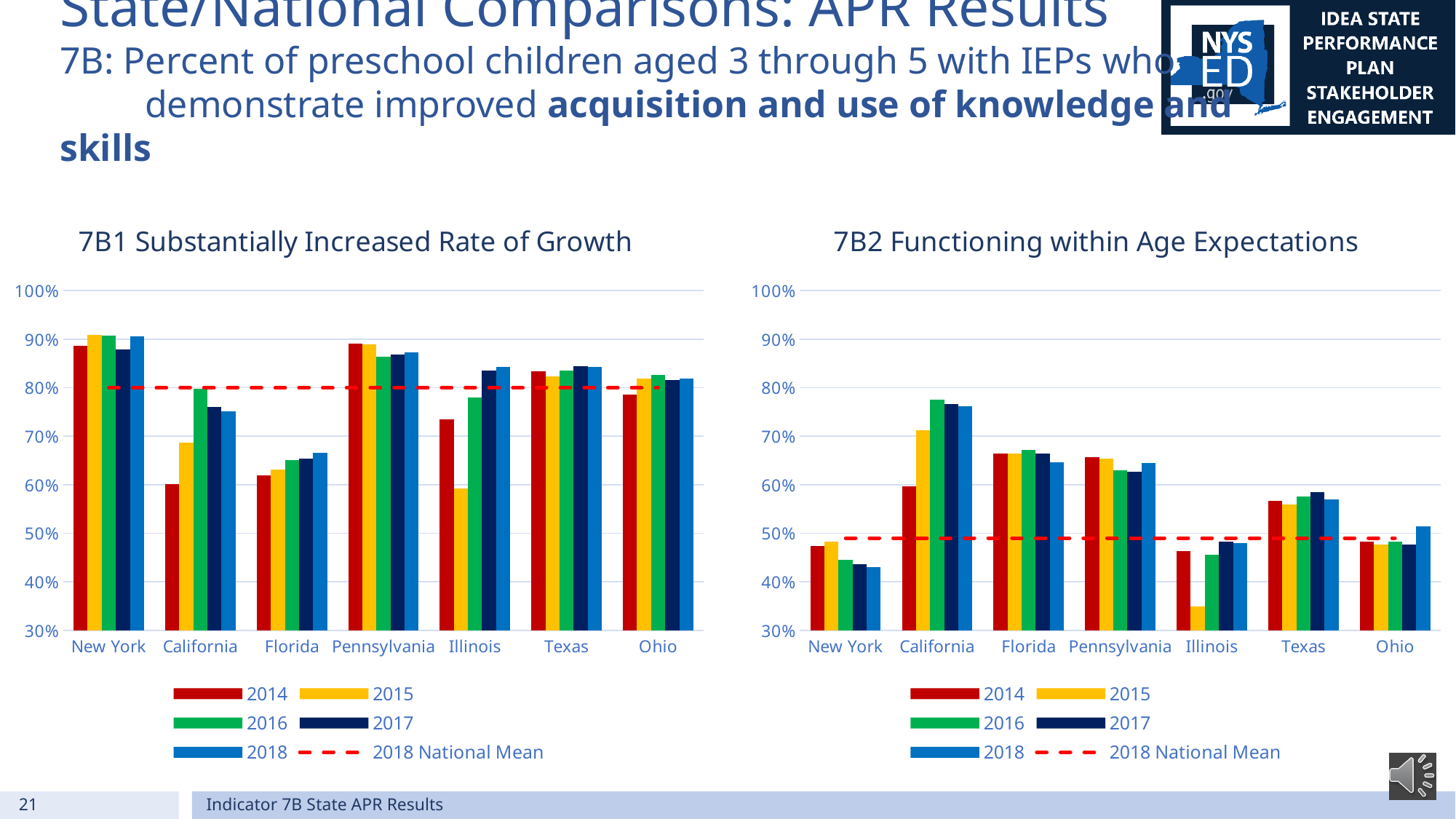
In the 7B1 Substantially Increased Rate of Growth chart, do Florida's values rise or fall from 2014 to 2018? rise In the 7B2 Functioning within Age Expectations chart, is the 2016 value for California greater or less than 70%? greater In the 7B1 Substantially Increased Rate of Growth chart, what kind of chart is used? bar chart In the 7B1 Substantially Increased Rate of Growth chart, is the 2014 value for California greater or less than 70%? less In the 7B2 Functioning within Age Expectations chart, is the 2015 value for Illinois greater or less than 40%? less In the 7B2 Functioning within Age Expectations chart, which state has the highest 2016 value? California In the 7B1 Substantially Increased Rate of Growth chart, at what value is the 2018 National Mean dashed line drawn? 80% In the 7B2 Functioning within Age Expectations chart, which state has the lowest 2015 value? Illinois In the 7B1 Substantially Increased Rate of Growth chart, which is larger for California: the 2014 value or the 2016 value? 2016 In the 7B1 Substantially Increased Rate of Growth chart, how many entries does the legend list? 6 In the 7B2 Functioning within Age Expectations chart, how many states are shown on the x axis? 7